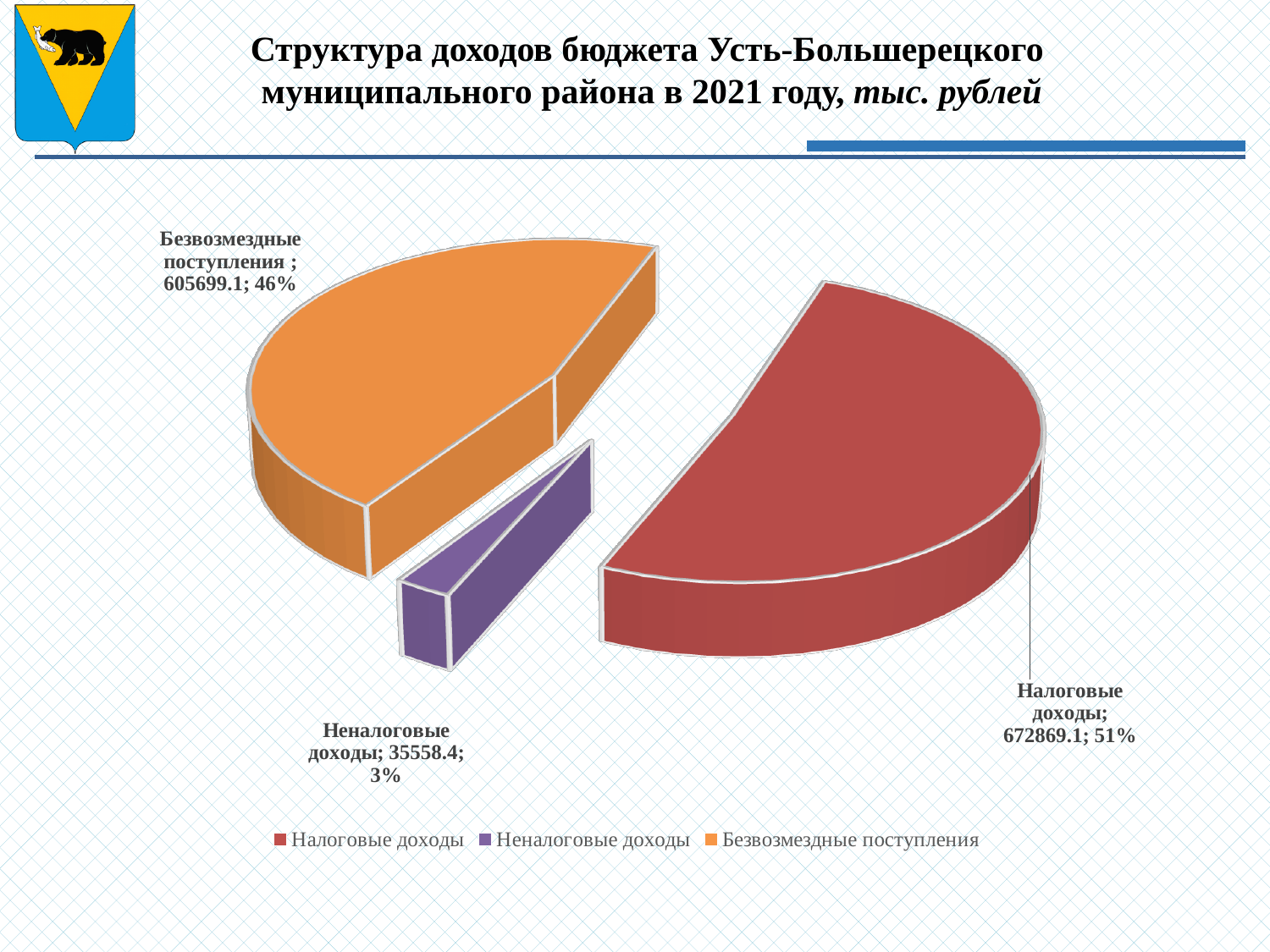
What is the difference between Налоговые доходы and Безвозмездные поступления? 67170.0 Which category has the smallest slice? Неналоговые доходы How many categories are shown in the pie chart? 3 What kind of chart is shown on the slide? Pie chart What is the value for Безвозмездные поступления? 605699.1 What is the value for Неналоговые доходы? 35558.4 Which is larger, Безвозмездные поступления or Неналоговые доходы? Безвозмездные поступления What share of the pie does Налоговые доходы take? 51% What is the value for Налоговые доходы? 672869.1 Which category has the largest slice? Налоговые доходы What share of the pie does Безвозмездные поступления take? 46% What colour is the slice for Неналоговые доходы? Purple